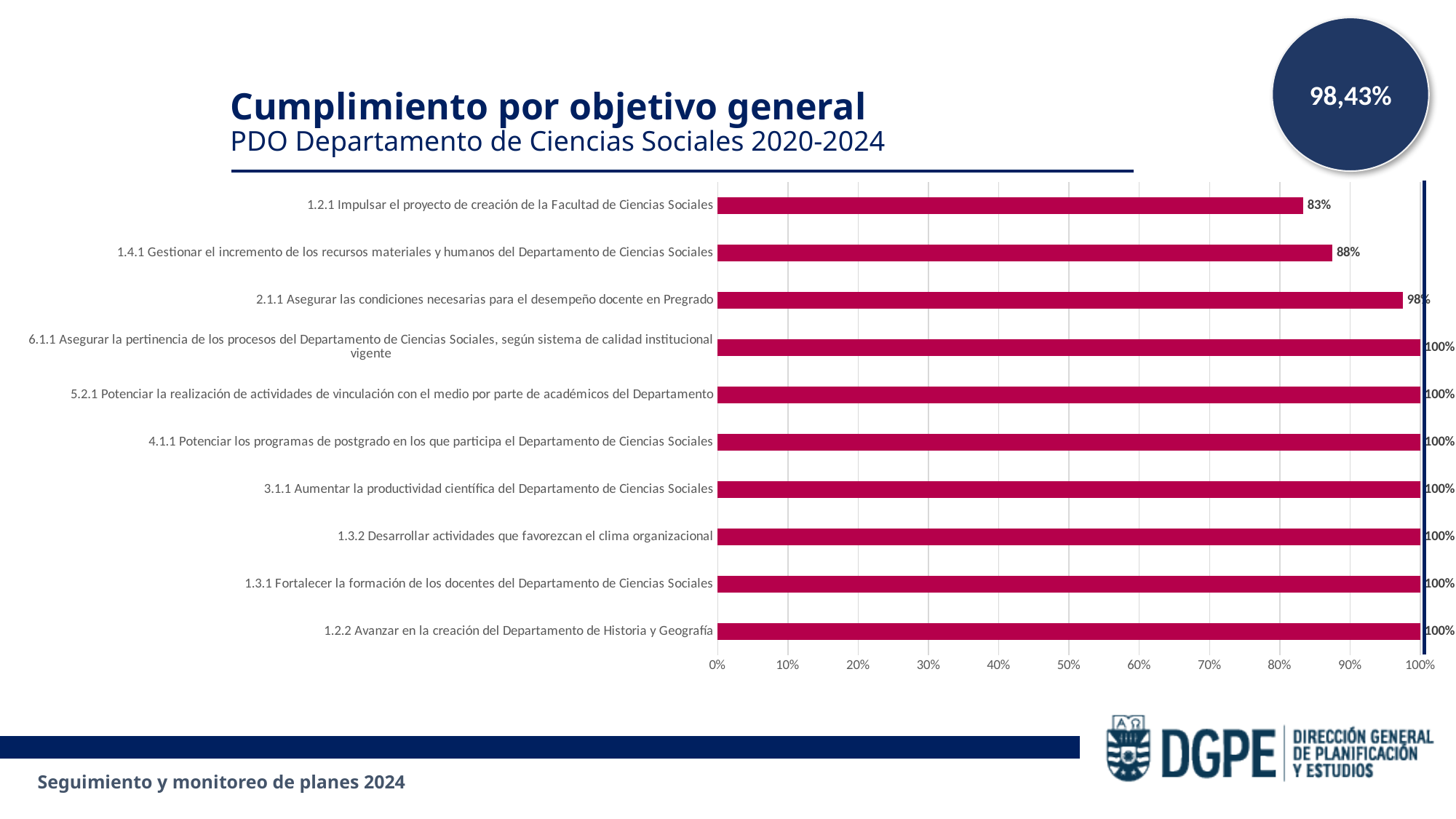
What is the difference between the values for 2.1.1 and 1.4.1? 10% How many objectives have a value of 100%? 7 Which is larger, the value for 1.4.1 or the value for 1.2.1? 1.4.1 What kind of chart is shown on the slide? bar chart Is the value for 1.2.1 greater or less than 90%? less What is the value for 1.2.2 Avanzar en la creación del Departamento de Historia y Geografía? 100% How many objectives are shown in the chart? 10 What is the value for 2.1.1 Asegurar las condiciones necesarias para el desempeño docente en Pregrado? 98% What is the difference between the values for 1.4.1 and 1.2.1? 5% What is the value for 1.4.1 Gestionar el incremento de los recursos materiales y humanos del Departamento de Ciencias Sociales? 88% What is the value for 1.2.1 Impulsar el proyecto de creación de la Facultad de Ciencias Sociales? 83% Which objective has the lowest value? 1.2.1 Impulsar el proyecto de creación de la Facultad de Ciencias Sociales